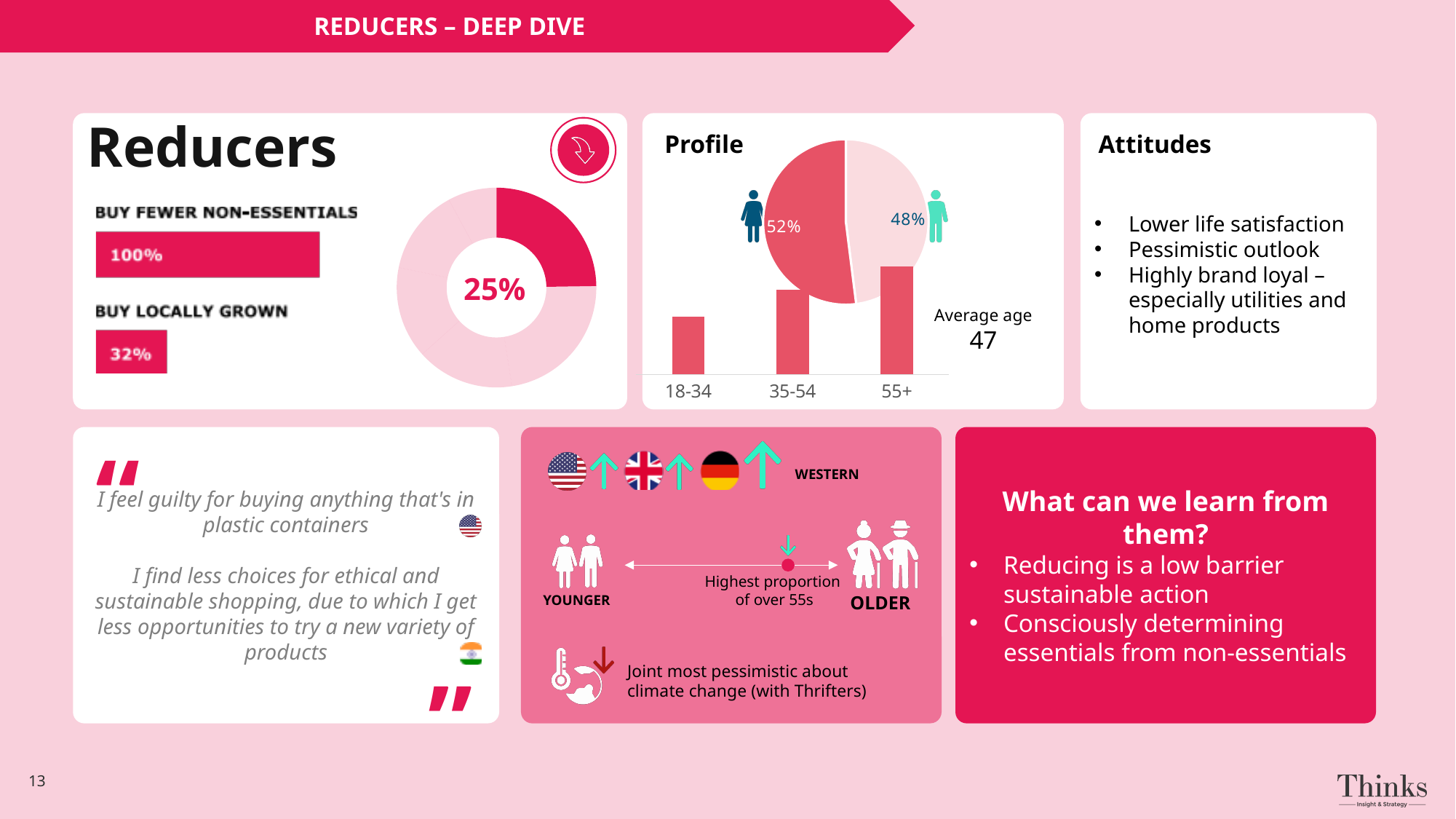
What kind of chart is the one showing 25% in the Reducers panel? Donut chart In the Reducers panel, which is larger: 'Buy fewer non-essentials' or 'Buy locally grown'? Buy fewer non-essentials In the Profile pie chart, which segment is larger, male or female? Male How many age groups are shown in the Profile bar chart? 3 In the Reducers panel, what value is shown for 'Buy fewer non-essentials'? 100% In the Profile pie chart, what share is shown for the male segment? 52% In the Profile age bar chart, which age group has the lowest bar? 18-34 What percentage is shown in the centre of the donut chart in the Reducers panel? 25% In the Reducers panel, what is the difference between the 'Buy fewer non-essentials' and 'Buy locally grown' values? 68% In the Profile age bar chart, which age group has the highest bar? 55+ In the Reducers panel, what value is shown for 'Buy locally grown'? 32% In the Profile pie chart, what share is shown for the female segment? 48%